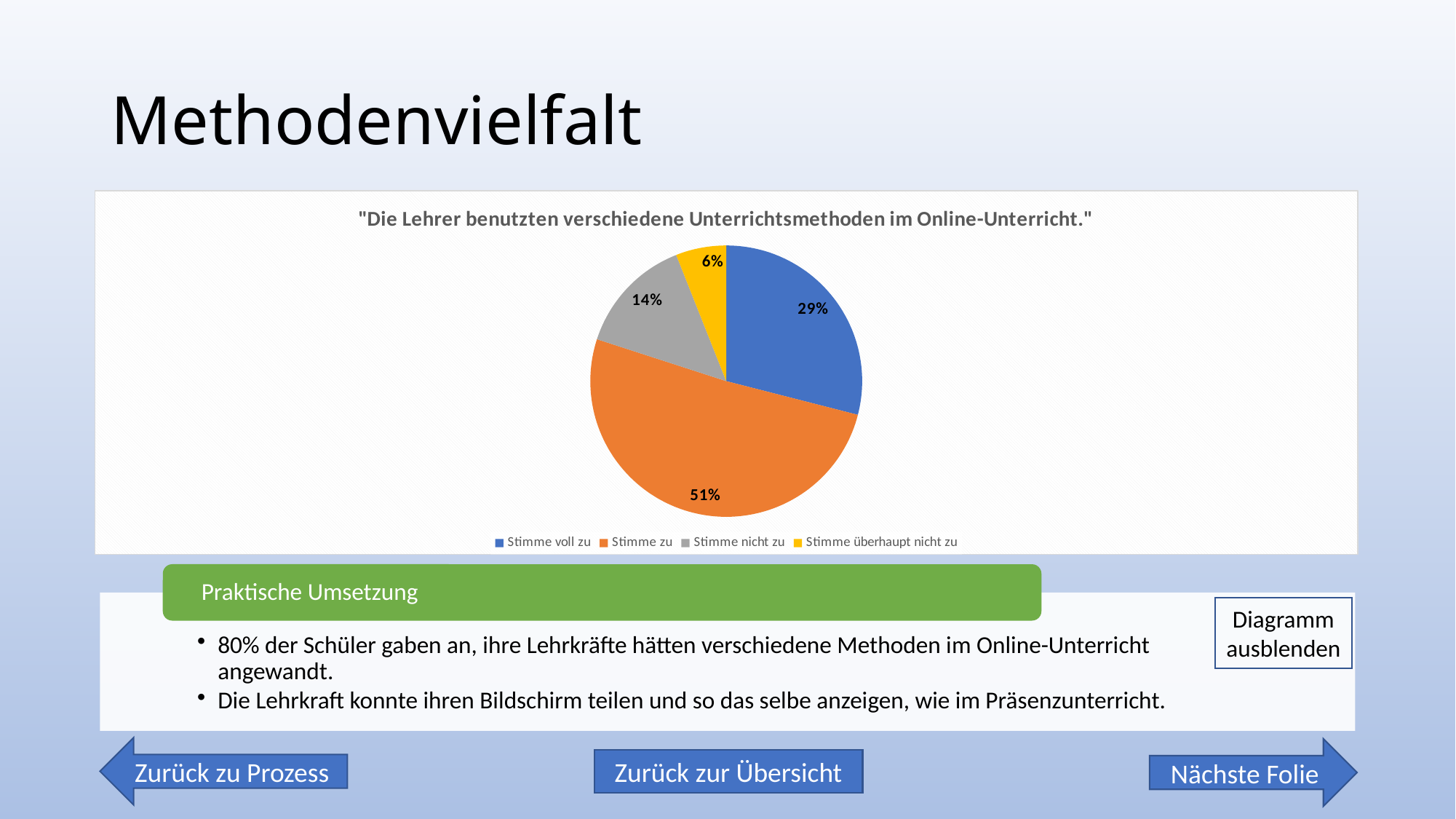
What share of the pie is labelled "Stimme überhaupt nicht zu"? 6% How many slices does the pie chart have? 4 What kind of chart is shown on the slide? pie chart What is the difference in percentage points between "Stimme zu" and "Stimme voll zu"? 22 Which category has the smallest slice of the pie? Stimme überhaupt nicht zu What share of the pie is labelled "Stimme nicht zu"? 14% What share of the pie is labelled "Stimme voll zu"? 29% What is the title of the pie chart? "Die Lehrer benutzten verschiedene Unterrichtsmethoden im Online-Unterricht." Which is larger, the slice for "Stimme nicht zu" or the slice for "Stimme überhaupt nicht zu"? Stimme nicht zu Which colour represents "Stimme voll zu" in the pie chart? blue Which category has the largest slice of the pie? Stimme zu